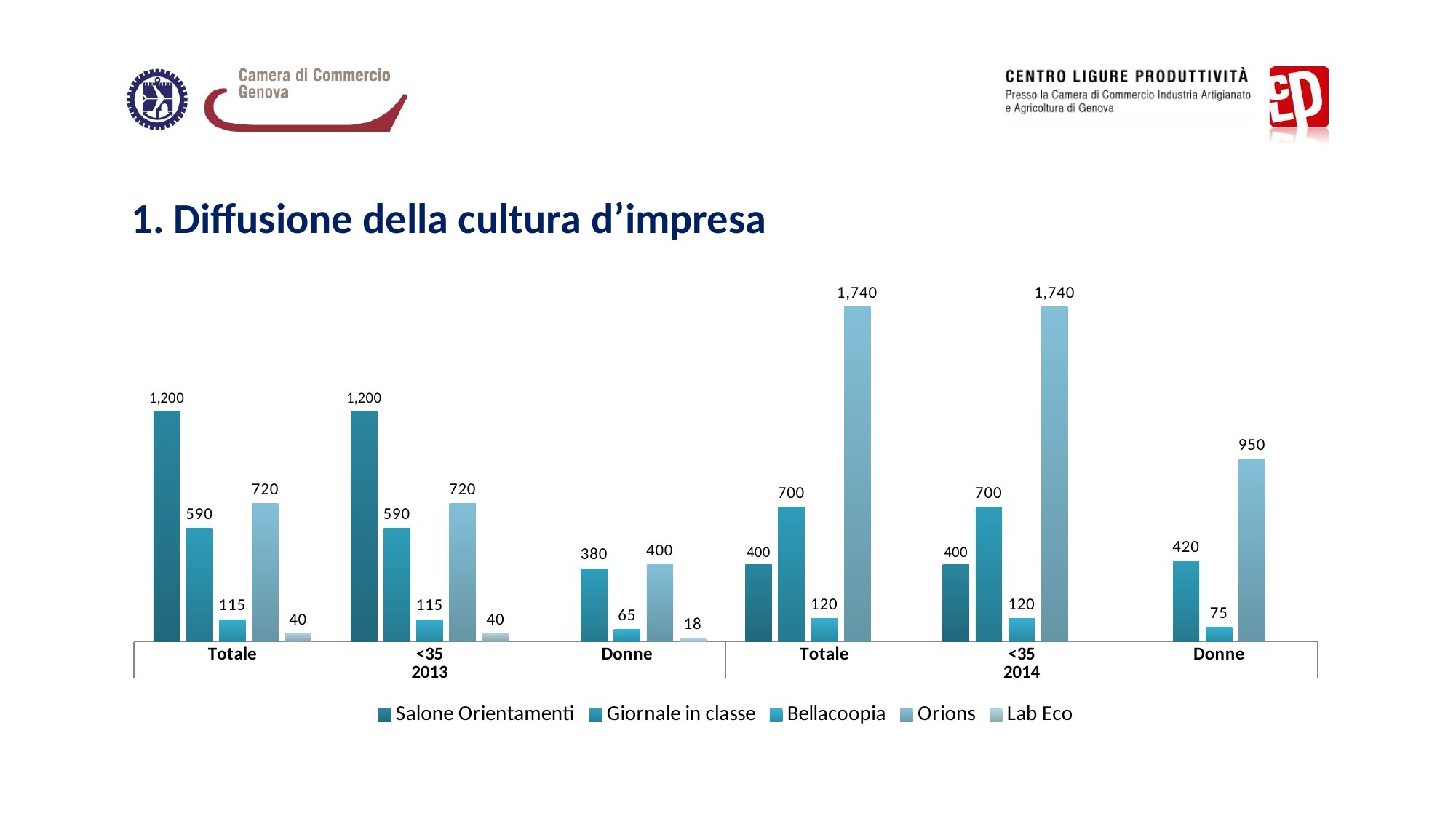
Which series has the highest value in Totale 2014? Orions What kind of chart is shown on the slide? bar chart Which series has the lowest value in <35 2013? Lab Eco Which is larger in Donne 2013: Orions or Giornale in classe? Orions What is the title of the slide? 1. Diffusione della cultura d'impresa What is the value for Giornale in classe in Donne 2014? 420 What is the value for Orions in Totale 2014? 1,740 How many series does the legend list? 5 What is the difference between Orions and Giornale in classe in Totale 2014? 1,040 What is the value for Salone Orientamenti in Totale 2013? 1,200 How does the Salone Orientamenti value for Totale change from 2013 to 2014? It falls from 1,200 to 400 What is the value for Lab Eco in Donne 2013? 18